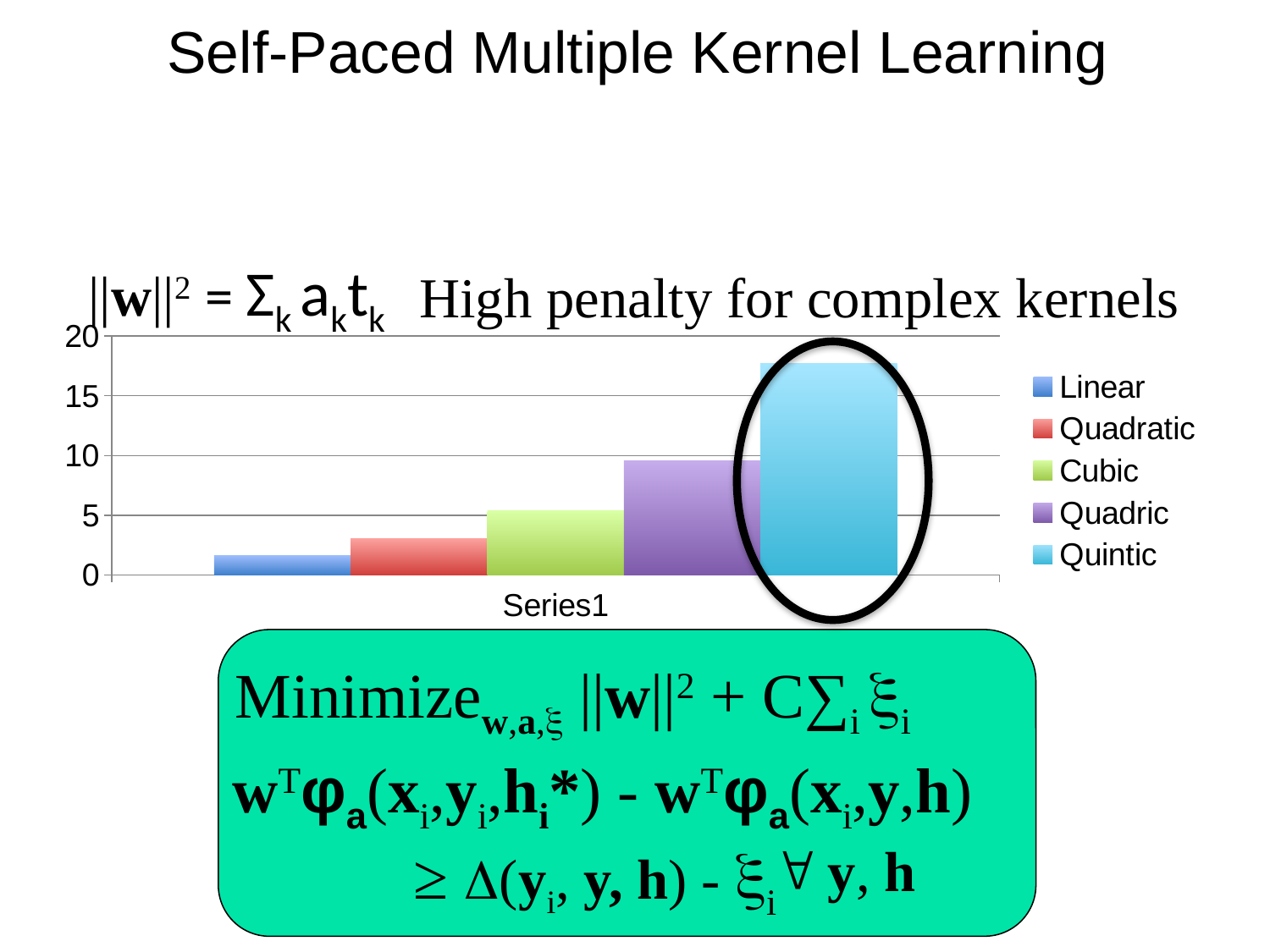
Is the value for Quintic greater or less than 15? greater Is the value for Quadric greater or less than 5? greater Which series has the lowest bar in the chart? Linear What kind of chart is shown on the slide? bar chart Which series has the highest bar in the chart? Quintic Which is larger, the bar for Quadric or the bar for Quintic? Quintic How many series does the chart's legend list? 5 Is the value for Cubic greater or less than 10? less Do the bar heights rise or fall going from Linear to Quintic? rise Which is larger, the bar for Cubic or the bar for Quadratic? Cubic Which series' bar is circled in black on the chart? Quintic